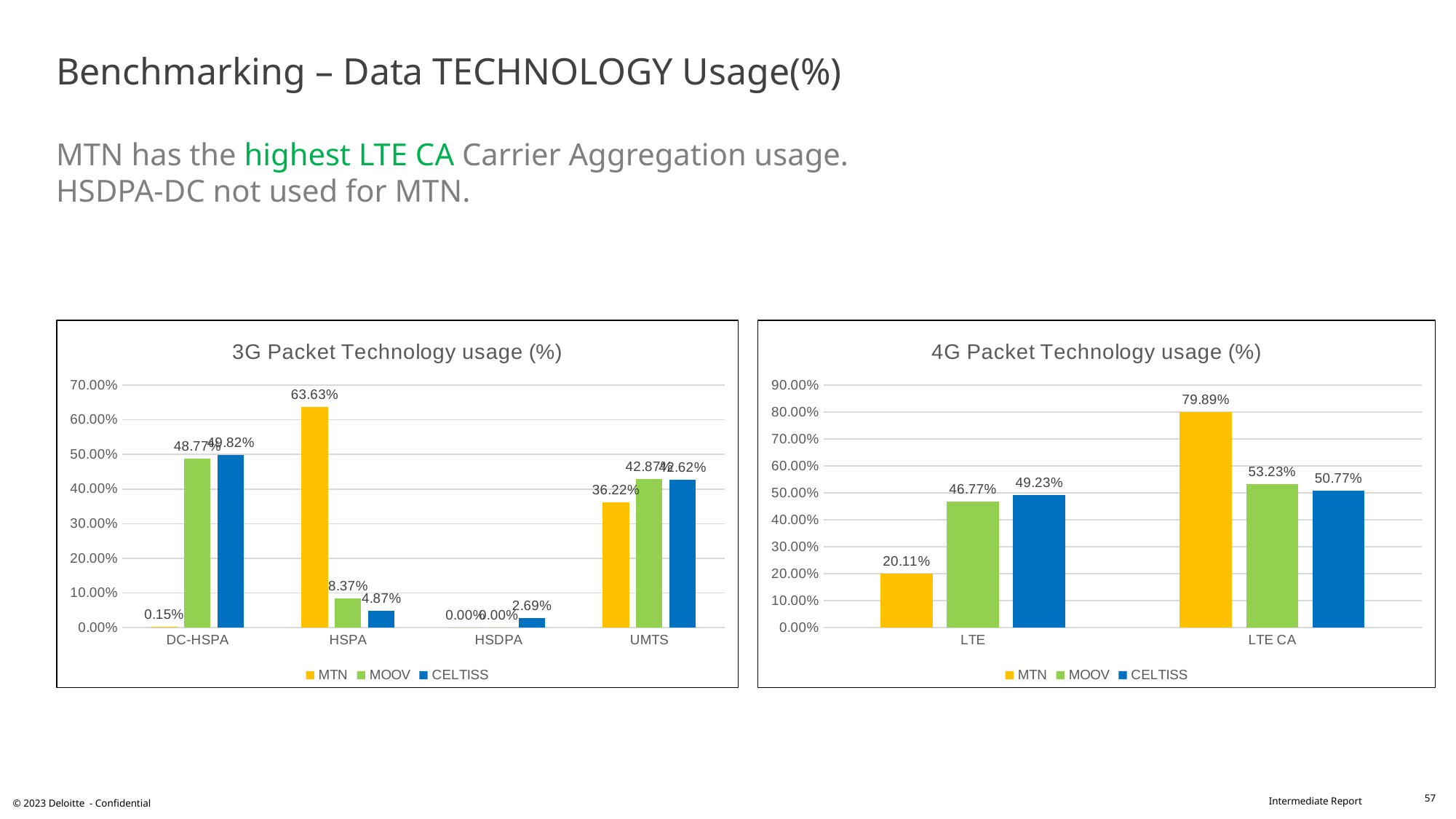
In the 4G Packet Technology usage chart, what is the value for MTN in the LTE CA category? 79.89% In the 3G Packet Technology usage chart, what is the value for CELTISS in the HSDPA category? 2.69% How many technology categories are shown on the x axis of the 3G Packet Technology usage chart? 4 In the 3G Packet Technology usage chart, what is the difference between MOOV's and CELTISS's HSPA values? 3.50% In the 4G Packet Technology usage chart, which is larger for LTE: MOOV or CELTISS? CELTISS In the 4G Packet Technology usage chart, what is the value for CELTISS in the LTE category? 49.23% In the 4G Packet Technology usage chart, what is the difference between MTN's and MOOV's LTE CA values? 26.66% In the 3G Packet Technology usage chart, which operator has the lowest DC-HSPA usage? MTN How many series does the legend of the 4G Packet Technology usage chart list? 3 In the 3G Packet Technology usage chart, what is the value for MTN in the HSPA category? 63.63% In the 4G Packet Technology usage chart, which operator has the highest LTE CA usage? MTN What kind of chart is the 3G Packet Technology usage chart? Bar chart